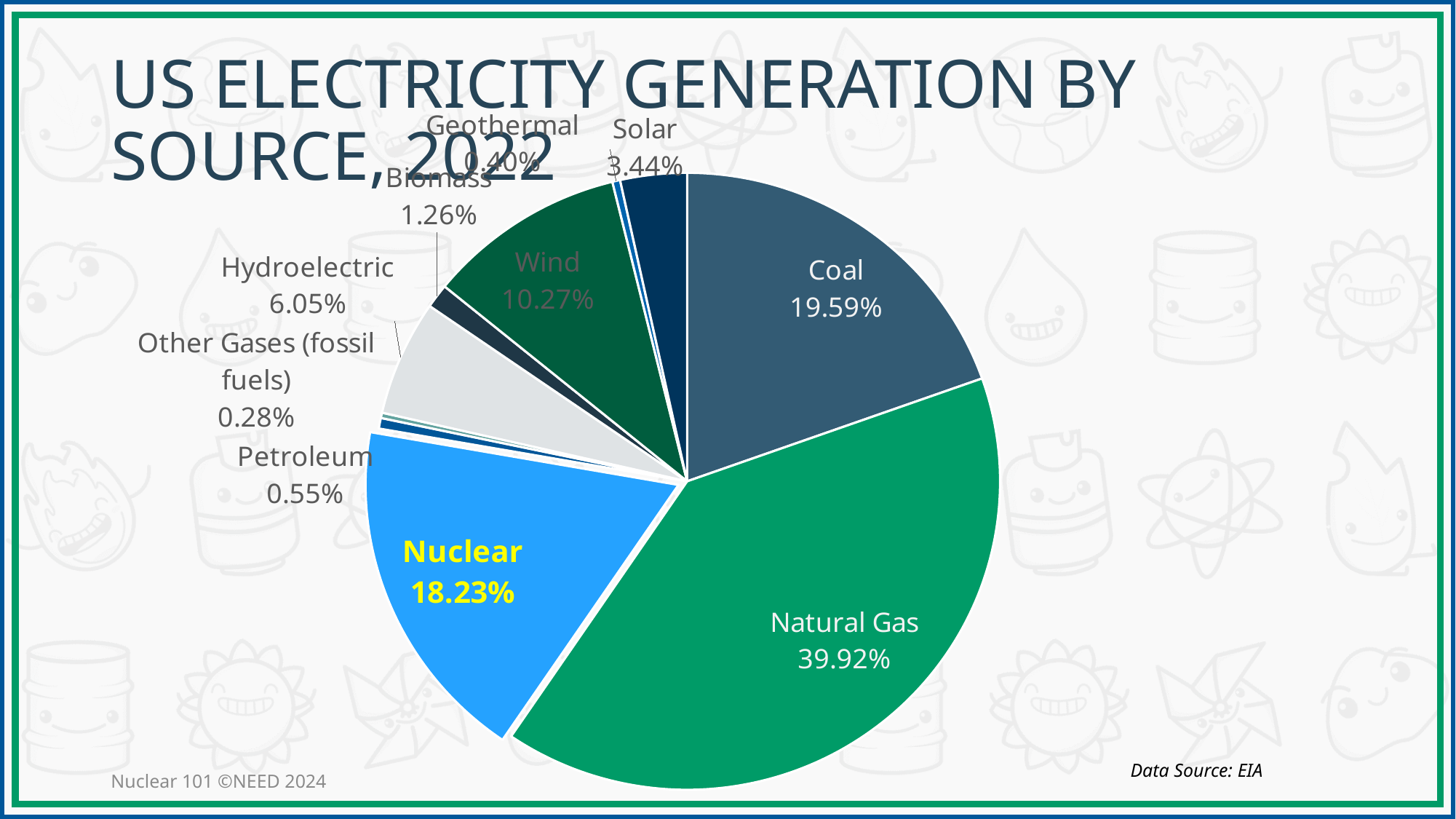
What is the title of the chart? US ELECTRICITY GENERATION BY SOURCE, 2022 What is the difference in percentage points between Coal and Nuclear? 1.36 Which is larger, the share for Solar or the share for Biomass? Solar Which source has the smallest share in the pie chart? Other Gases (fossil fuels) What percentage is shown for Nuclear? 18.23% What is the value shown for Hydroelectric? 6.05% Which source has the largest share of US electricity generation in 2022? Natural Gas How many sources are shown in the pie chart? 10 What type of chart is shown on the slide? Pie chart What percentage of generation is attributed to Wind? 10.27% What share of US electricity generation in 2022 came from Natural Gas? 39.92% What is the value shown for Coal? 19.59%